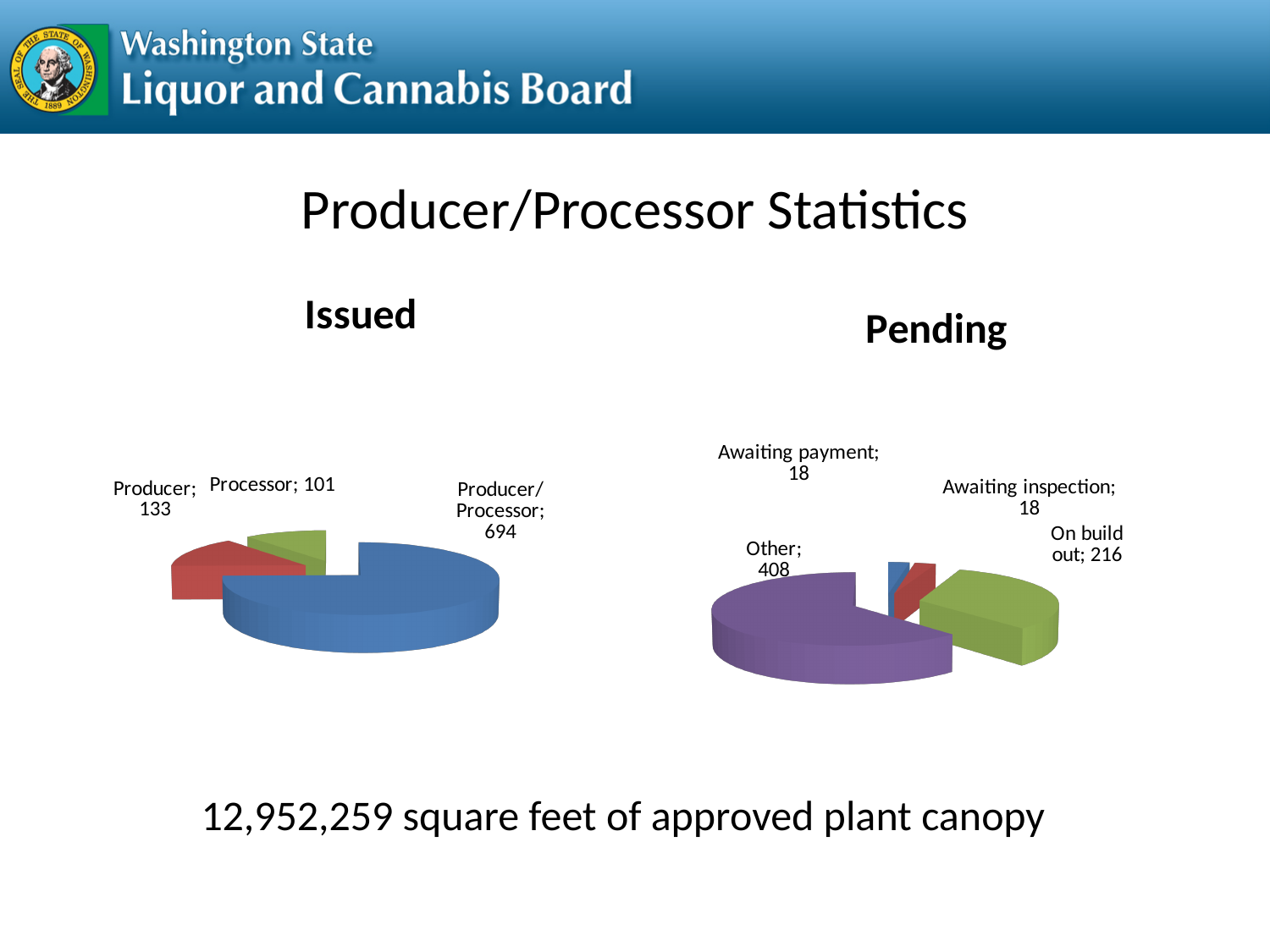
In the Issued chart, which category has the smallest slice? Processor In the Pending chart, which category has the largest slice? Other In the Pending chart, what is the difference between Other and On build out? 192 In the Pending chart, what is the value for On build out? 216 What type of chart is the Issued chart? Pie chart In the Issued chart, what is the value for Producer/Processor? 694 In the Pending chart, what is the value for Other? 408 How many categories does the Pending chart show? 4 In the Issued chart, what is the difference between the Producer and Processor values? 32 In the Pending chart, which is larger, On build out or Awaiting payment? On build out In the Issued chart, what is the value for Processor? 101 In the Issued chart, what is the total of all slices? 928